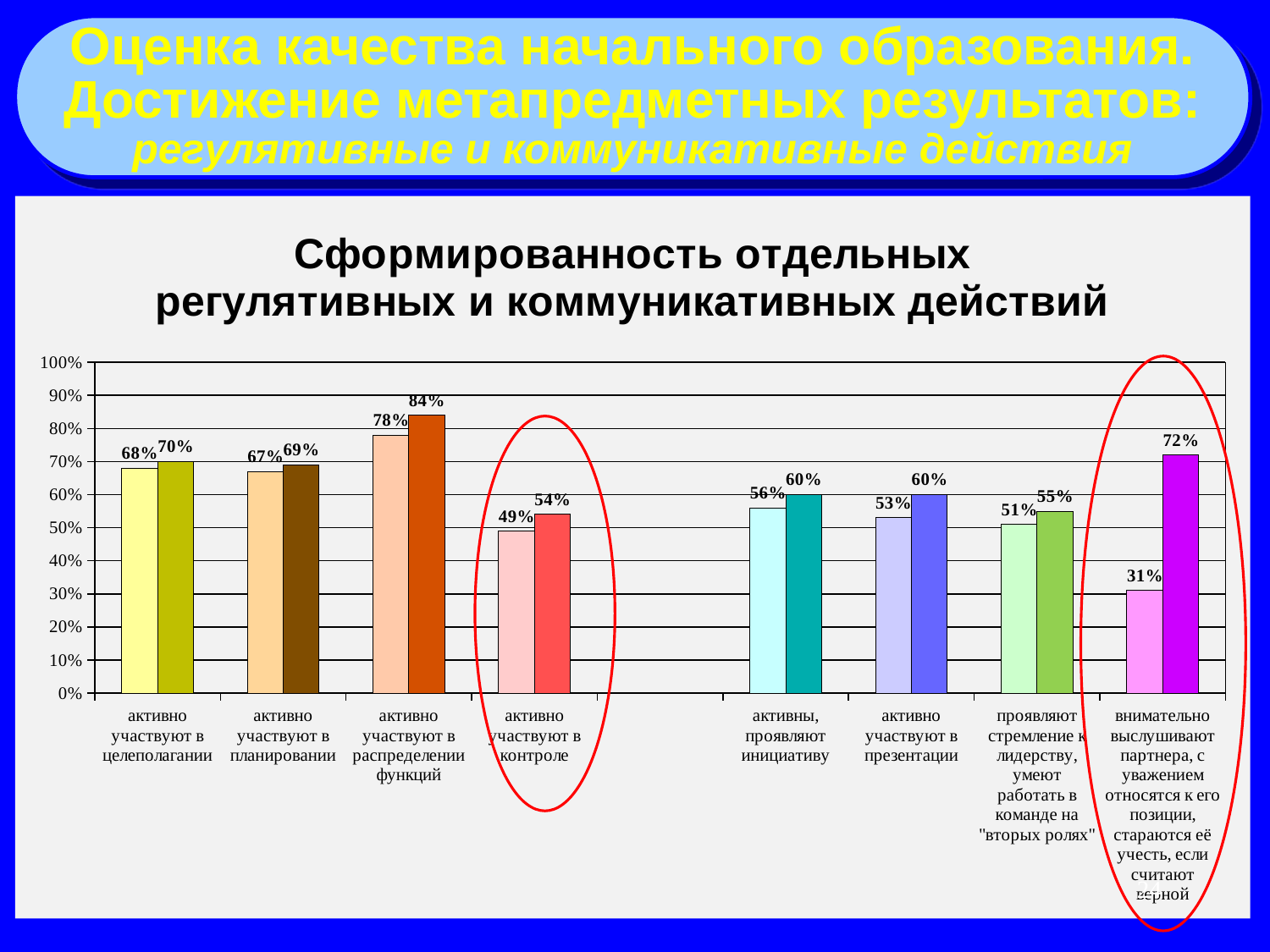
What is the difference between the left and right bars for "активно участвуют в контроле"? 5% What is the value of the left bar for "внимательно выслушивают партнера"? 31% Which category has the highest value among all bars in the chart? активно участвуют в распределении функций Which category has the lowest value among all bars in the chart? внимательно выслушивают партнера What is the value of the right bar for "активно участвуют в распределении функций"? 84% How many categories are shown along the x axis of the chart? 8 What is the value of the left bar for "активно участвуют в контроле"? 49% Which is larger: the right bar for "активно участвуют в презентации" or the right bar for "проявляют стремление к лидерству"? активно участвуют в презентации What is the title of the chart? Сформированность отдельных регулятивных и коммуникативных действий What is the difference between the two bars for "внимательно выслушивают партнера"? 41% What type of chart is shown on the slide? bar chart What is the value of the left bar for "активны, проявляют инициативу"? 56%